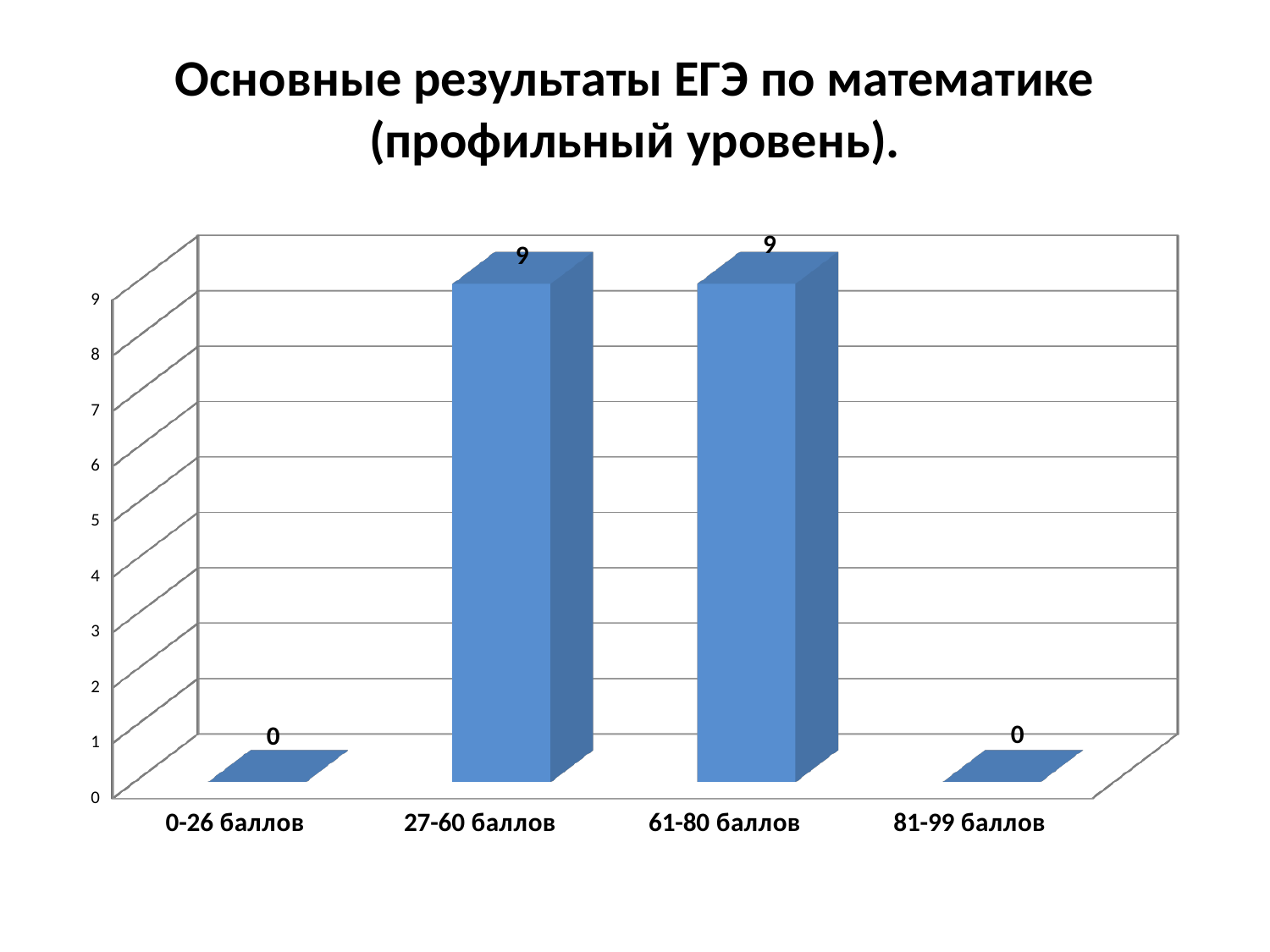
What kind of chart is shown on the slide? bar chart What is the value for the 81-99 баллов category? 0 What is the value for the 61-80 баллов category? 9 What is the value for the 27-60 баллов category? 9 What is the difference between the values for 27-60 баллов and 0-26 баллов? 9 Is the value for 27-60 баллов greater or less than 5? greater What is the total of all four category values? 18 What is the title of the slide? Основные результаты ЕГЭ по математике (профильный уровень). Which is larger, the value for 61-80 баллов or the value for 81-99 баллов? 61-80 баллов What is the value for the 0-26 баллов category? 0 How many categories are shown on the x axis? 4 What is the highest value shown on the vertical axis? 9